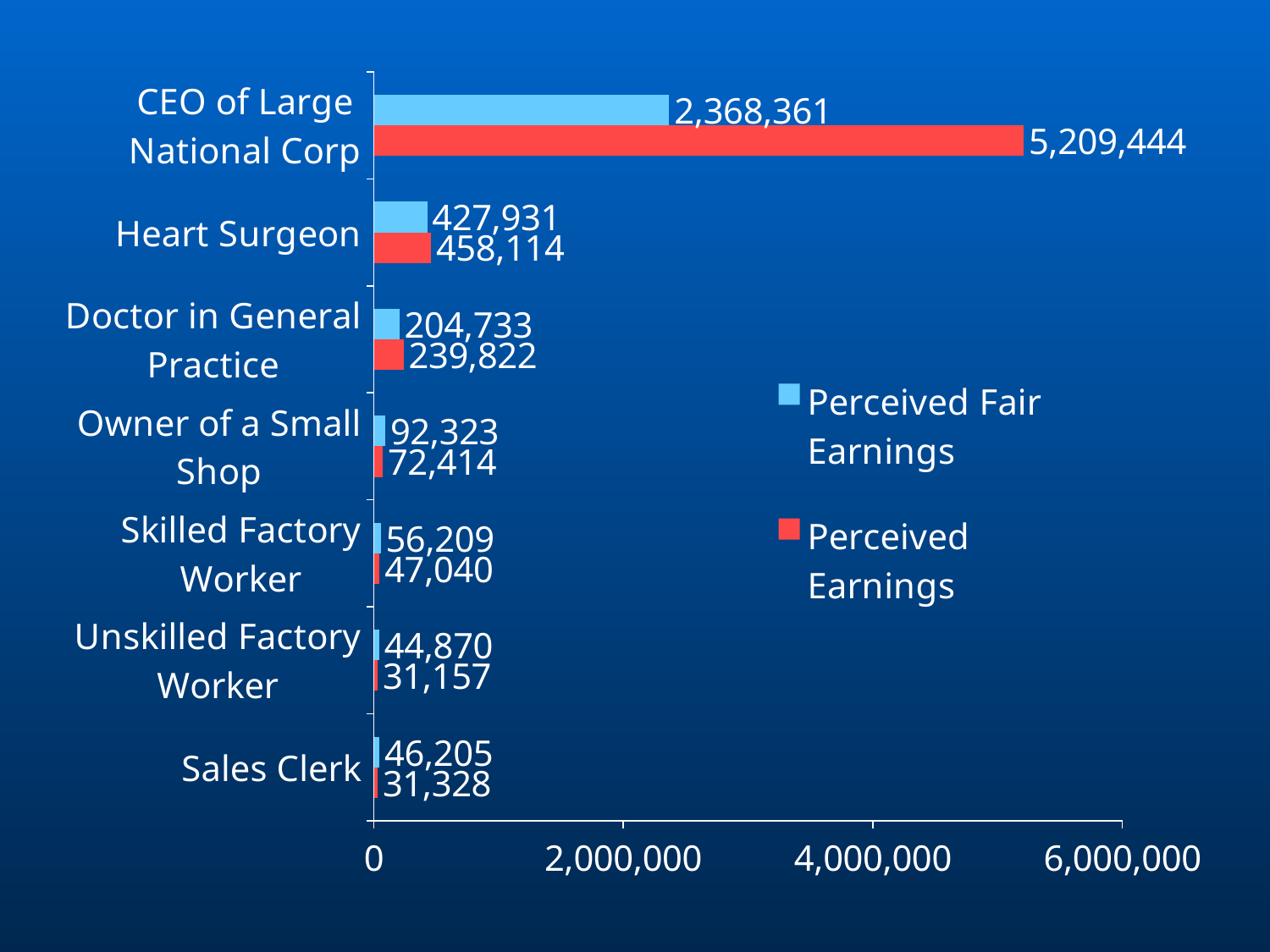
What is the Perceived Fair Earnings value for Sales Clerk? 46,205 What is the Perceived Earnings value for Doctor in General Practice? 239,822 Which category has the highest Perceived Earnings? CEO of Large National Corp How many series does the legend list? 2 What is the difference between Perceived Fair Earnings and Perceived Earnings for Owner of a Small Shop? 19,909 What is the Perceived Fair Earnings value for Heart Surgeon? 427,931 What is the Perceived Earnings value for CEO of Large National Corp? 5,209,444 For Heart Surgeon, which is larger: Perceived Fair Earnings or Perceived Earnings? Perceived Earnings How many occupation categories are shown on the chart? 7 Is the Perceived Earnings value for CEO of Large National Corp greater or less than 4,000,000? greater What is the difference between Perceived Earnings and Perceived Fair Earnings for CEO of Large National Corp? 2,841,083 What kind of chart is shown on the slide? Bar chart